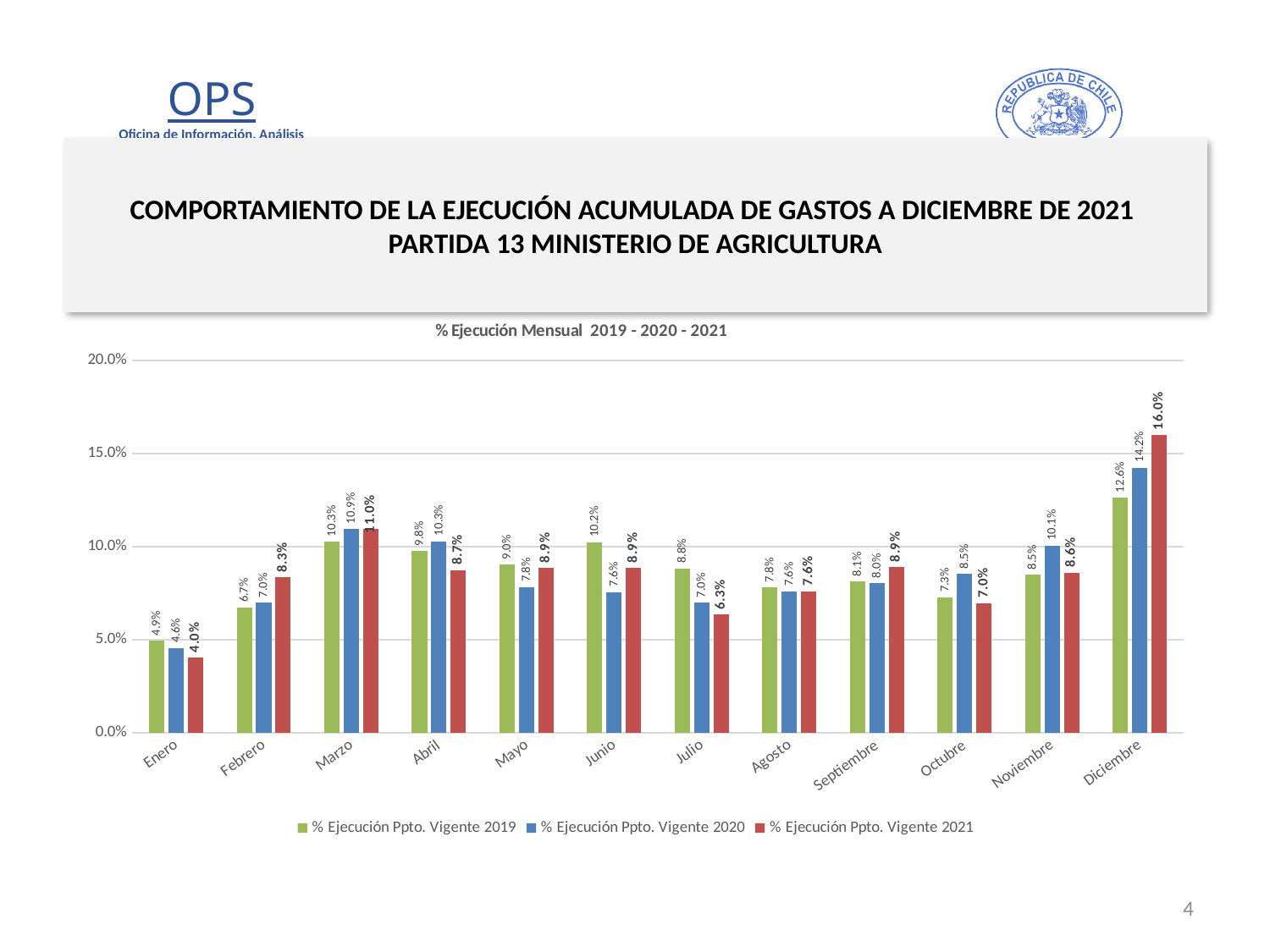
What is the difference between the 2021 and 2019 values in Diciembre? 3.4% What kind of chart is shown on the slide? Bar chart What is the value for % Ejecución Ppto. Vigente 2020 in Noviembre? 10.1% What is the value for % Ejecución Ppto. Vigente 2019 in Enero? 4.9% What is the value for % Ejecución Ppto. Vigente 2021 in Diciembre? 16.0% What is the title of the chart? % Ejecución Mensual 2019 - 2020 - 2021 How many months are shown on the x axis? 12 Which is larger in Julio: the 2019 value or the 2021 value? 2019 value (8.8%) Which month has the lowest value for % Ejecución Ppto. Vigente 2020? Enero Is the value for % Ejecución Ppto. Vigente 2020 in Diciembre greater or less than 15.0%? less Which month has the highest value for % Ejecución Ppto. Vigente 2021? Diciembre How many series does the legend list? 3